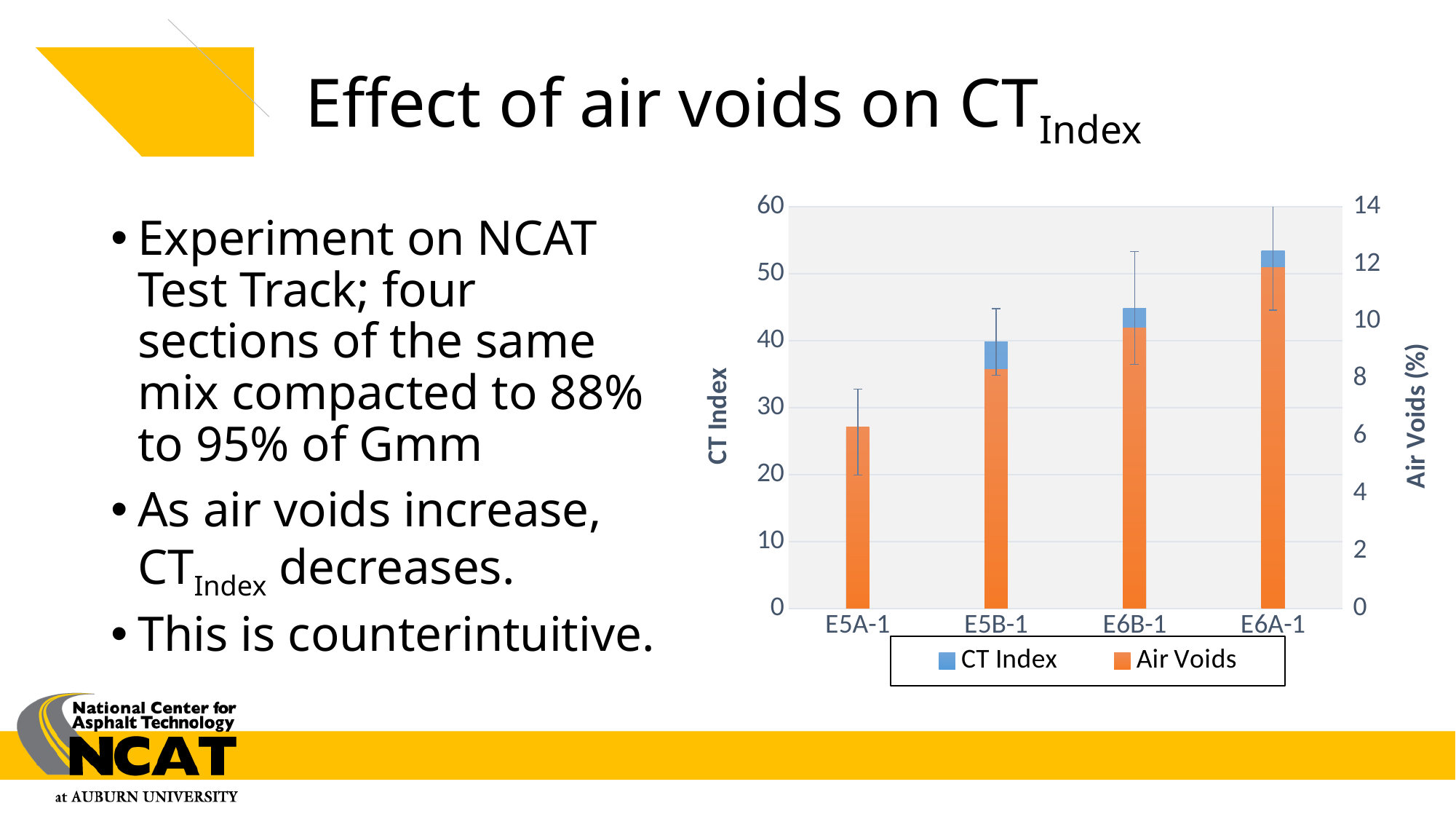
Is the CT Index value for E5A-1 greater or less than 30? less What kind of chart is shown on the slide? bar chart What is the title of the right-hand vertical axis of the chart? Air Voids (%) Which section has a higher CT Index, E6B-1 or E5A-1? E6B-1 Which section has the tallest bars in the chart? E6A-1 How many test sections (categories) are shown on the x axis of the chart? 4 Is the Air Voids value for E6A-1 greater or less than 10? greater Is the Air Voids value for E5A-1 greater or less than 8? less How many series does the chart legend list? 2 Do the bar heights rise or fall from E5A-1 to E6A-1 along the x axis? rise Which section has the shortest bars in the chart? E5A-1